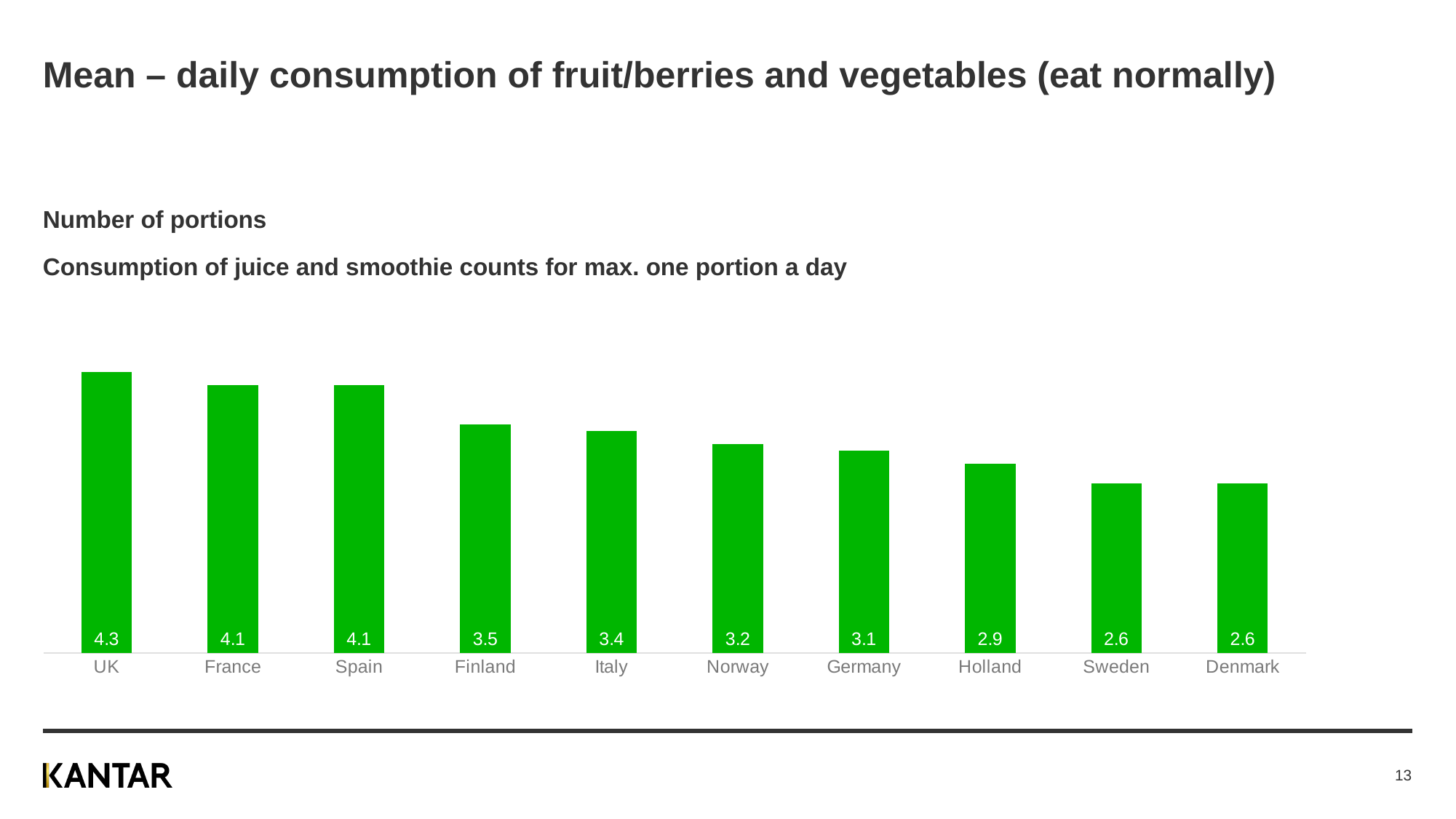
How many countries are shown in the chart? 10 What is the mean number of daily portions for Germany? 3.1 Which has a higher value, Italy or Germany? Italy What type of chart is shown on the slide? Bar chart What is the mean number of daily portions for Holland? 2.9 What is the lowest value shown in the chart? 2.6 What is the difference between the values for the UK and Denmark? 1.7 What colour are the bars in the chart? Green What is the mean number of daily portions for the UK? 4.3 Which country has the highest mean daily consumption of fruit/berries and vegetables? UK Do the values rise or fall from left to right across the chart? Fall What is the difference between the values for Finland and Norway? 0.3